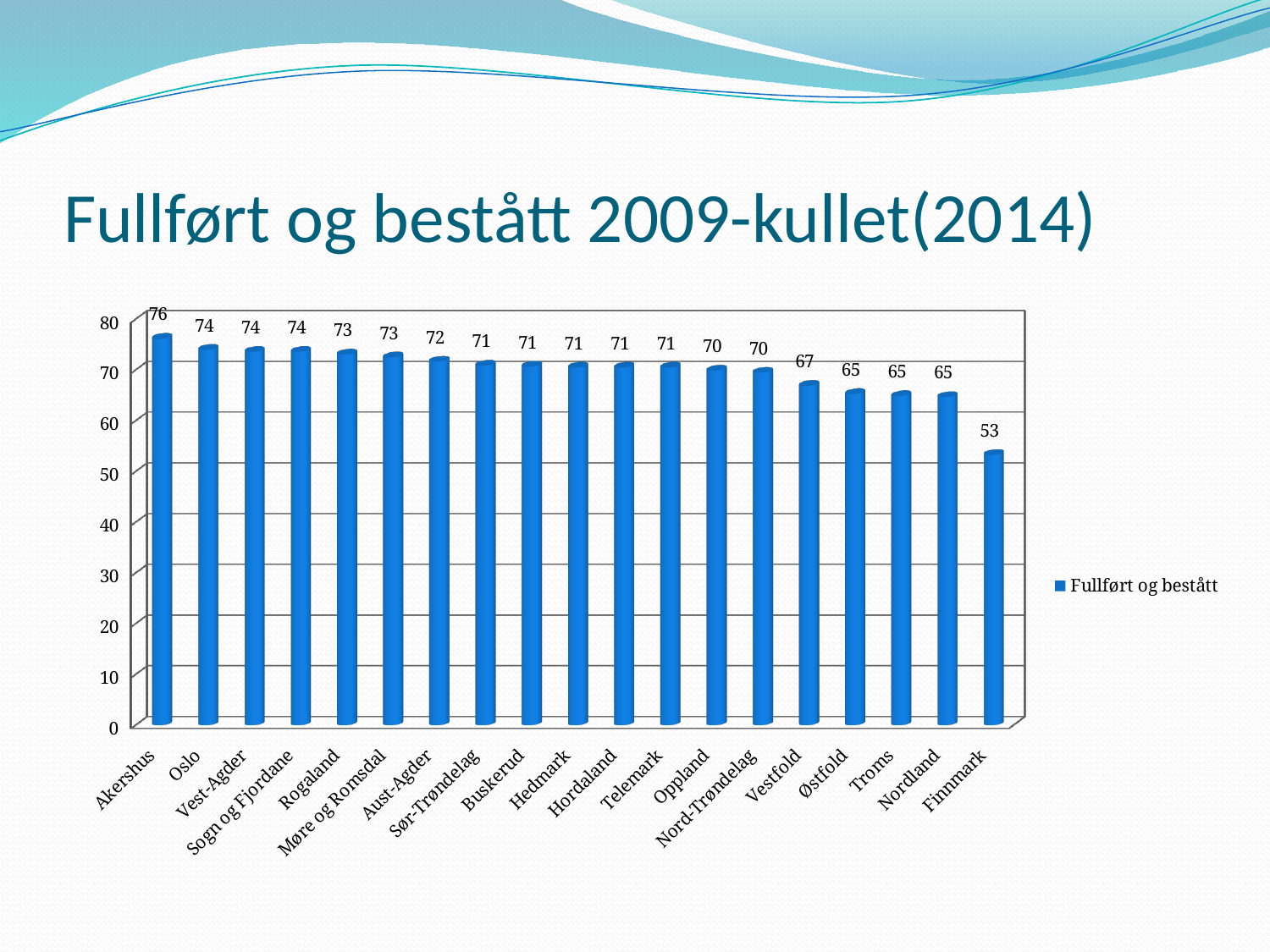
How many series does the legend list? 1 Which category has the lowest value? Finnmark What is the value for Aust-Agder? 72 Which is larger, the value for Oslo or the value for Østfold? Oslo What is the legend entry for the series? Fullført og bestått What is the value for Finnmark? 53 What is the value for Vestfold? 67 Which category has the highest value? Akershus What kind of chart is shown on the slide? Bar chart What is the value for Akershus? 76 What is the difference between the values for Akershus and Finnmark? 23 How many categories are shown on the x axis? 19